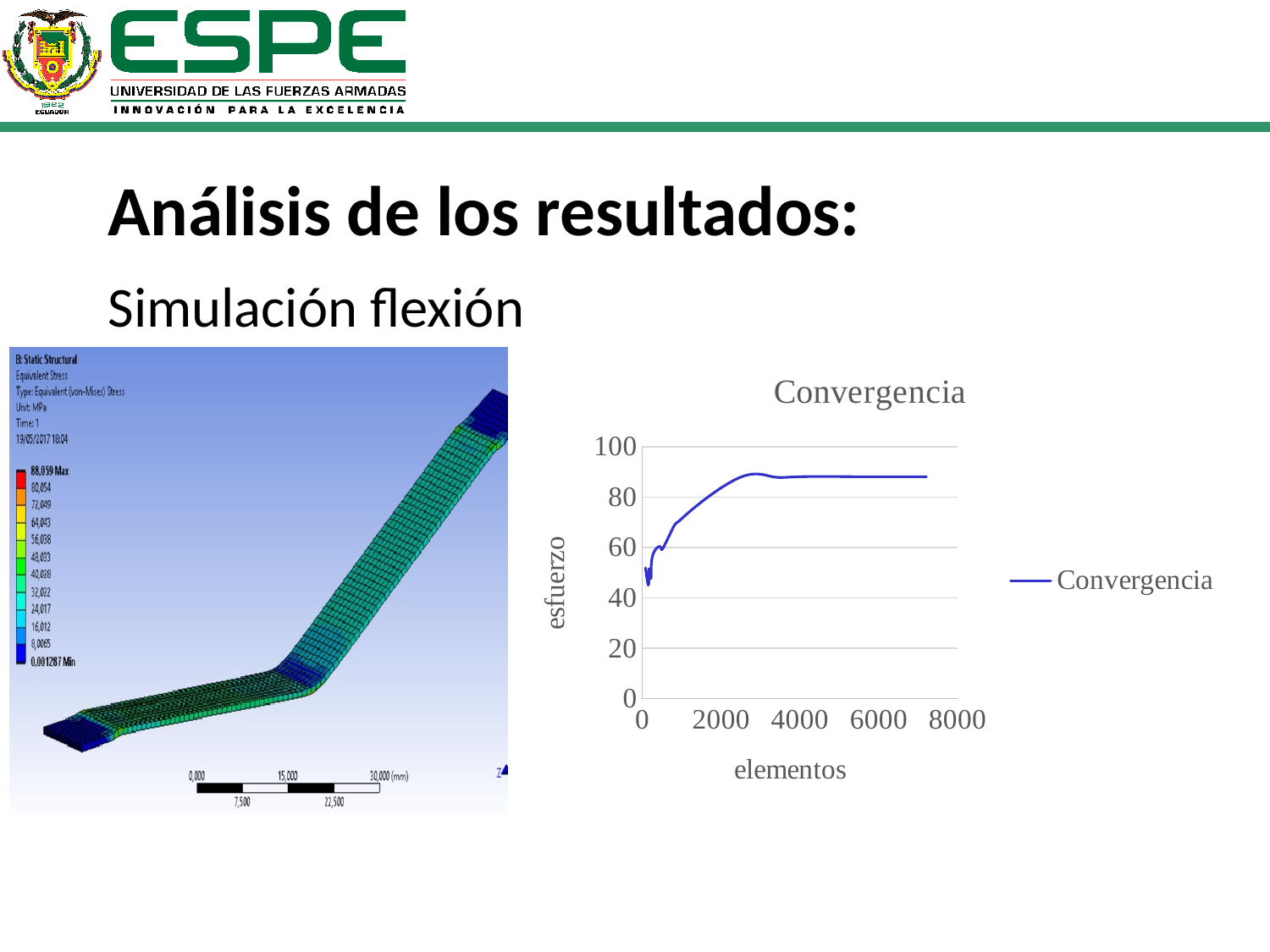
What is the title of the chart? Convergencia Is the value of the Convergencia line at 2000 elementos greater or less than 60? greater Is the value of the Convergencia line at 4000 elementos greater or less than 40? greater Does the Convergencia line overall rise or fall as elementos increases from 0 to about 3000? rise What is the highest tick value shown on the y axis of the chart? 100 Is the value of the Convergencia line at 4000 elementos greater or less than 100? less How many series does the chart's legend list? 1 What kind of chart is shown on the slide? line chart What is the label of the x axis of the chart? elementos